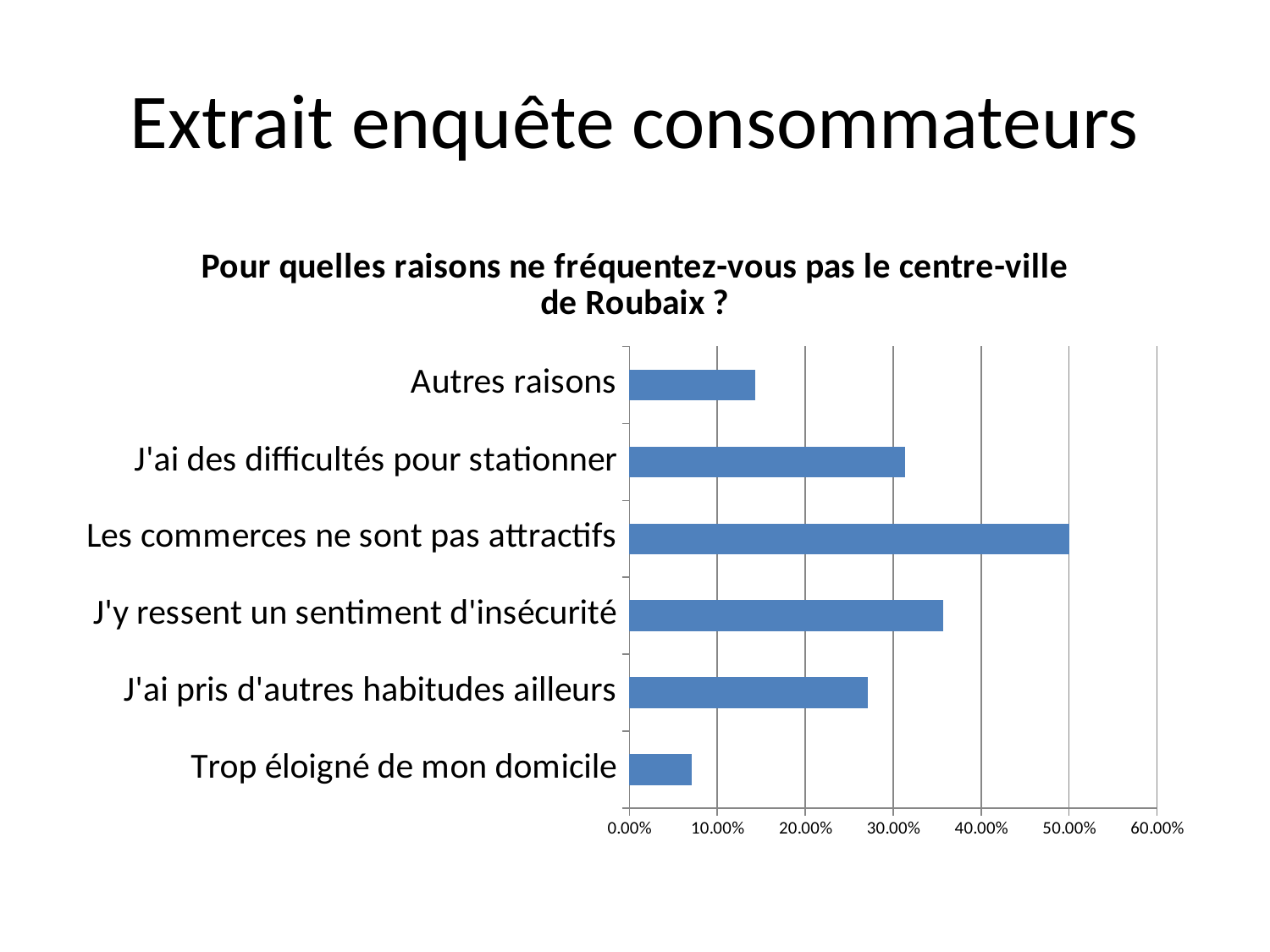
Is the value for "J'ai des difficultés pour stationner" greater or less than 30.00%? greater What kind of chart is shown on the slide? bar chart Is the value for "Trop éloigné de mon domicile" greater or less than 10.00%? less Which is larger: the value for "J'y ressent un sentiment d'insécurité" or for "Autres raisons"? J'y ressent un sentiment d'insécurité How many categories (reasons) are plotted in the chart? 6 Is the value for "J'y ressent un sentiment d'insécurité" greater or less than 30.00%? greater What is the title of the chart? Pour quelles raisons ne fréquentez-vous pas le centre-ville de Roubaix ? Which reason has the lowest value in the chart? Trop éloigné de mon domicile What is the value for "Les commerces ne sont pas attractifs"? 50.00% Which reason has the highest value in the chart? Les commerces ne sont pas attractifs Which is larger: the value for "J'ai des difficultés pour stationner" or for "J'ai pris d'autres habitudes ailleurs"? J'ai des difficultés pour stationner